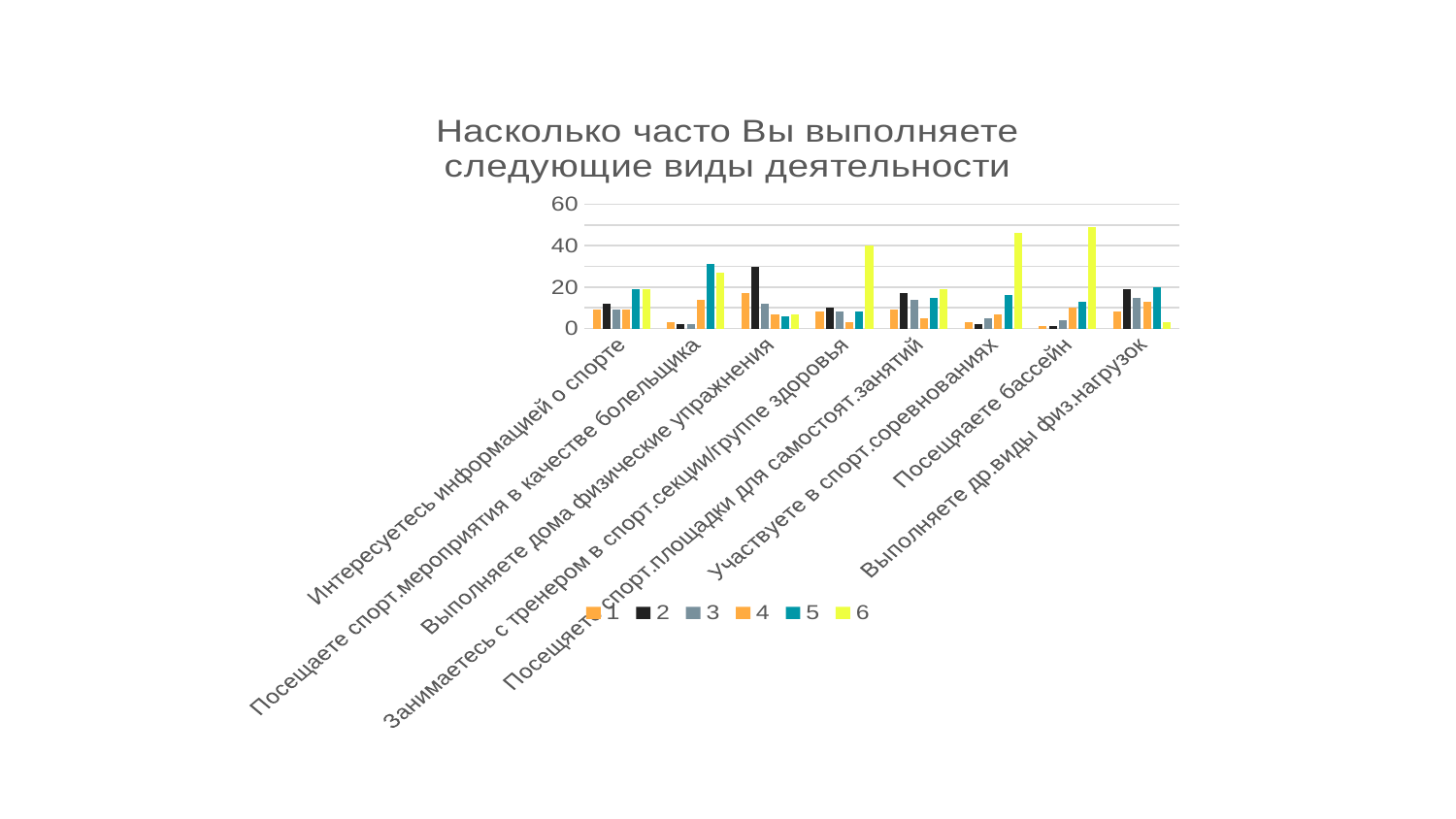
Is the value of series 6 for "Посещаете бассейн" greater or less than 40? greater What are the entries listed in the chart's legend? 1, 2, 3, 4, 5, 6 Is the value of series 5 for "Посещаете спорт.мероприятия в качестве болельщика" greater or less than 20? greater Is the value of series 6 for "Выполняете др.виды физ.нагрузок" greater or less than 20? less How many categories are shown along the x axis of the chart? 8 What is the title of the chart? Насколько часто Вы выполняете следующие виды деятельности How many series does the chart's legend list? 6 What kind of chart is shown on the slide? bar chart Which is larger: the value of series 6 for "Посещаете бассейн" or the value of series 6 for "Интересуетесь информацией о спорте"? Посещаете бассейн For "Выполняете дома физические упражнения", which is larger: the value of series 2 or the value of series 6? series 2